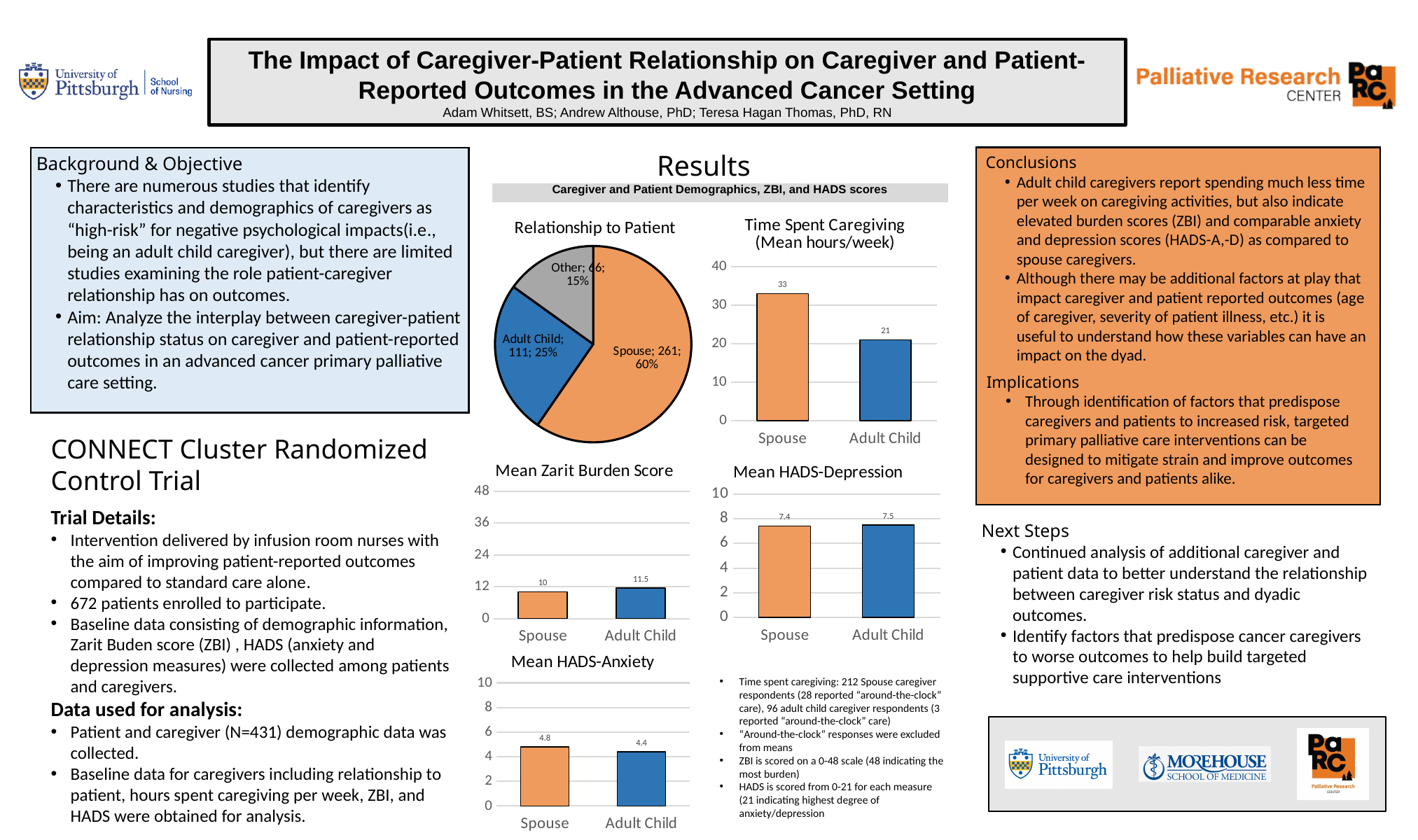
In the Mean HADS-Depression chart, what is the difference between Adult Child and Spouse? 0.1 In the Mean Zarit Burden Score chart, what is the value for Adult Child? 11.5 In the Time Spent Caregiving chart, what is the value for Spouse? 33 In the Mean Zarit Burden Score chart, is the value for Spouse greater or less than 12? less In the Relationship to Patient pie chart, which category has the smallest slice? Other In the Time Spent Caregiving chart, what is the difference between Spouse and Adult Child? 12 In the Relationship to Patient pie chart, what share of the pie is Spouse? 60% In the Relationship to Patient pie chart, what is the count for Adult Child? 111 What kind of chart is the Mean HADS-Anxiety chart? Bar chart How many slices does the Relationship to Patient pie chart have? 3 In the Time Spent Caregiving chart, which category has the higher value? Spouse In the Mean HADS-Anxiety chart, which category has the lower value? Adult Child